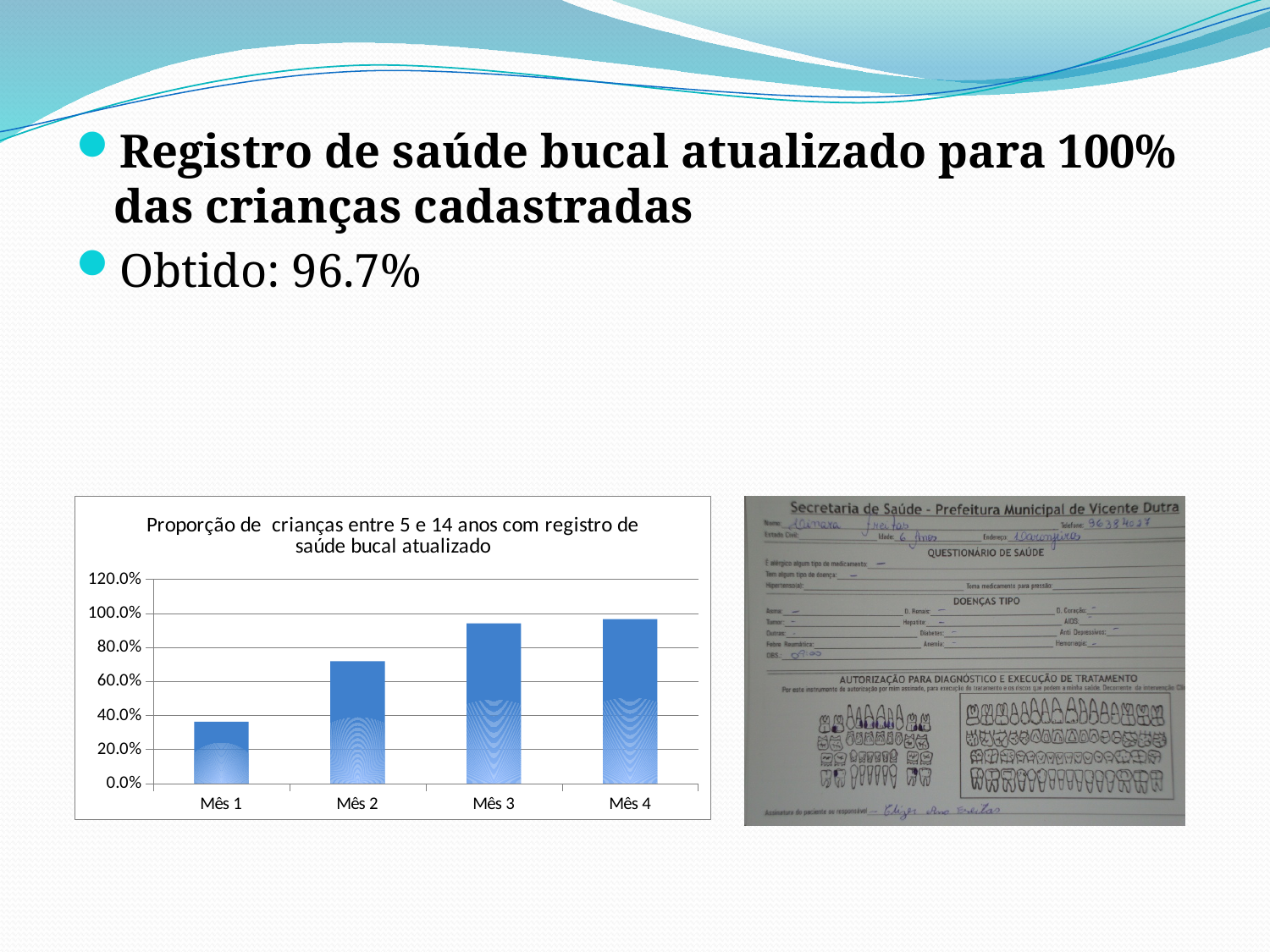
How many categories (months) are plotted on the x axis of the chart? 4 Do the values rise or fall from Mês 1 to Mês 4? rise Is the value for Mês 1 greater or less than 20.0%? greater What kind of chart is shown on the slide? bar chart Which month has the lowest value in the chart? Mês 1 What is the title of the chart? Proporção de crianças entre 5 e 14 anos com registro de saúde bucal atualizado Is the value for Mês 2 greater or less than 80.0%? less Is the value for Mês 1 greater or less than 40.0%? less Which is larger, the value for Mês 2 or the value for Mês 1? Mês 2